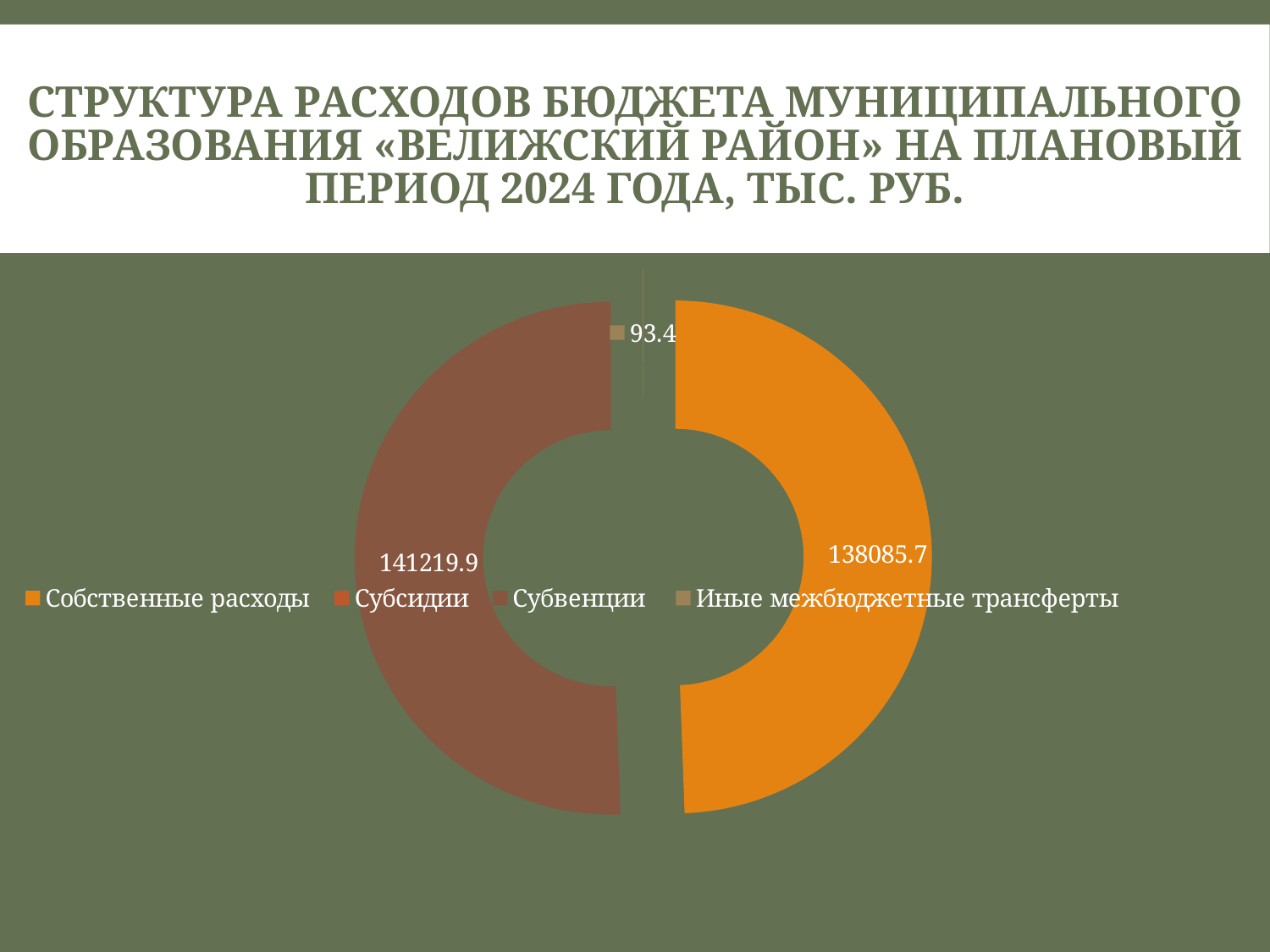
Which is larger, Собственные расходы or Субвенции? Субвенции What value is shown for Иные межбюджетные трансферты? 93.4 What colour represents Собственные расходы in the chart? Orange How many entries does the legend list? 4 Which category has the largest value on the chart? Субвенции What value is shown for Собственные расходы? 138085.7 Which labelled category has the smallest value on the chart? Иные межбюджетные трансферты In what units are the values on the slide expressed, according to the title? тыс. руб. Which is larger, Собственные расходы or Иные межбюджетные трансферты? Собственные расходы What value is shown for Субвенции? 141219.9 What kind of chart is shown on the slide? Doughnut (pie) chart What is the difference between the values for Субвенции and Собственные расходы? 3134.2